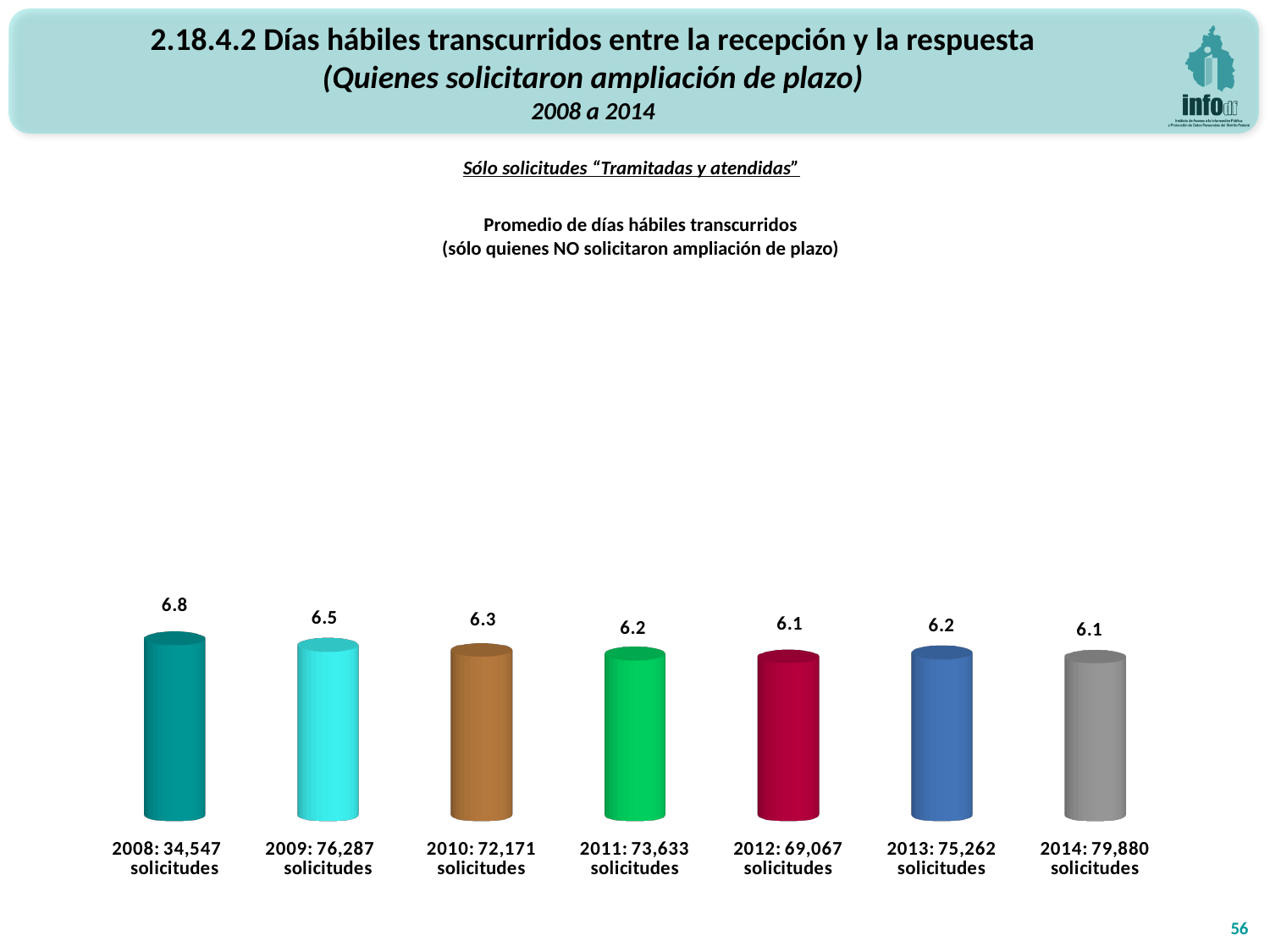
What is the difference between the values for 2009 and 2010? 0.2 What is the average number of business days shown for 2008? 6.8 What is the value plotted for 2011? 6.2 How many solicitudes are indicated in the label for 2014? 79,880 Which year has the highest average number of business days? 2008 Do the values generally rise or fall from 2008 to 2014? Fall What is the value plotted for 2014? 6.1 What is the difference between the values for 2008 and 2014? 0.7 Which is larger, the value for 2009 or the value for 2013? 2009 How many years (bars) are plotted in the chart? 7 What is the value plotted for 2012? 6.1 What kind of chart is shown on the slide? Bar chart